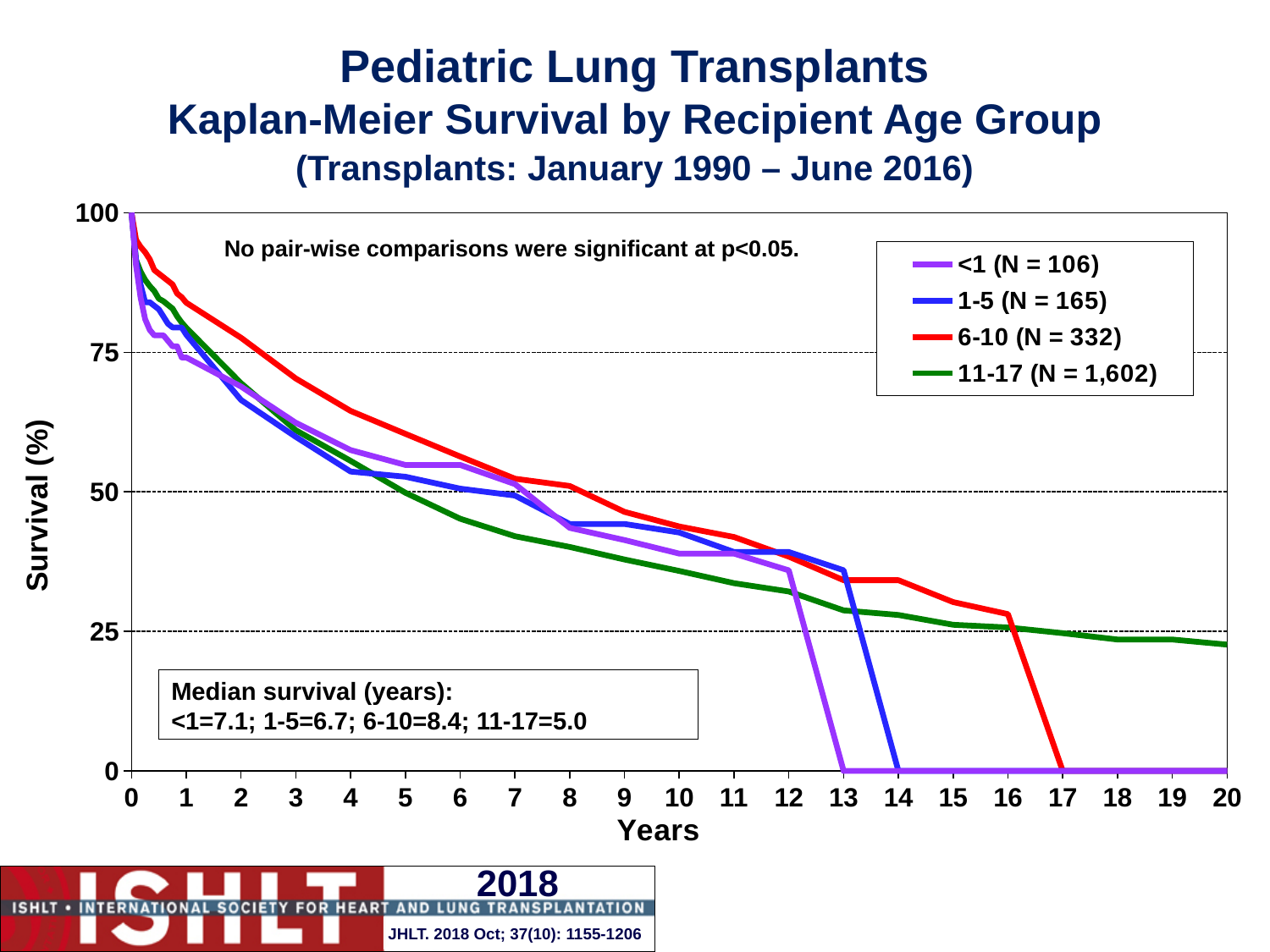
Which recipient age group is plotted with the green line? 11-17 What is the median survival in years for the 6-10 age group? 8.4 Is the survival value for the 6-10 group at 5 years greater or less than 50? greater Do the survival curves rise or fall as years increase along the x axis? fall Which recipient age group has the highest median survival? 6-10 Which recipient age group has the lowest median survival? 11-17 Which group has a larger N, 1-5 or 6-10? 6-10 What is the difference in median survival (years) between the 6-10 group and the 11-17 group? 3.4 What is the N for the 11-17 recipient age group shown in the legend? 1,602 How many series does the legend list? 4 What kind of chart is shown on the slide? line chart Is the survival value for the 11-17 group at 20 years greater or less than 25? less